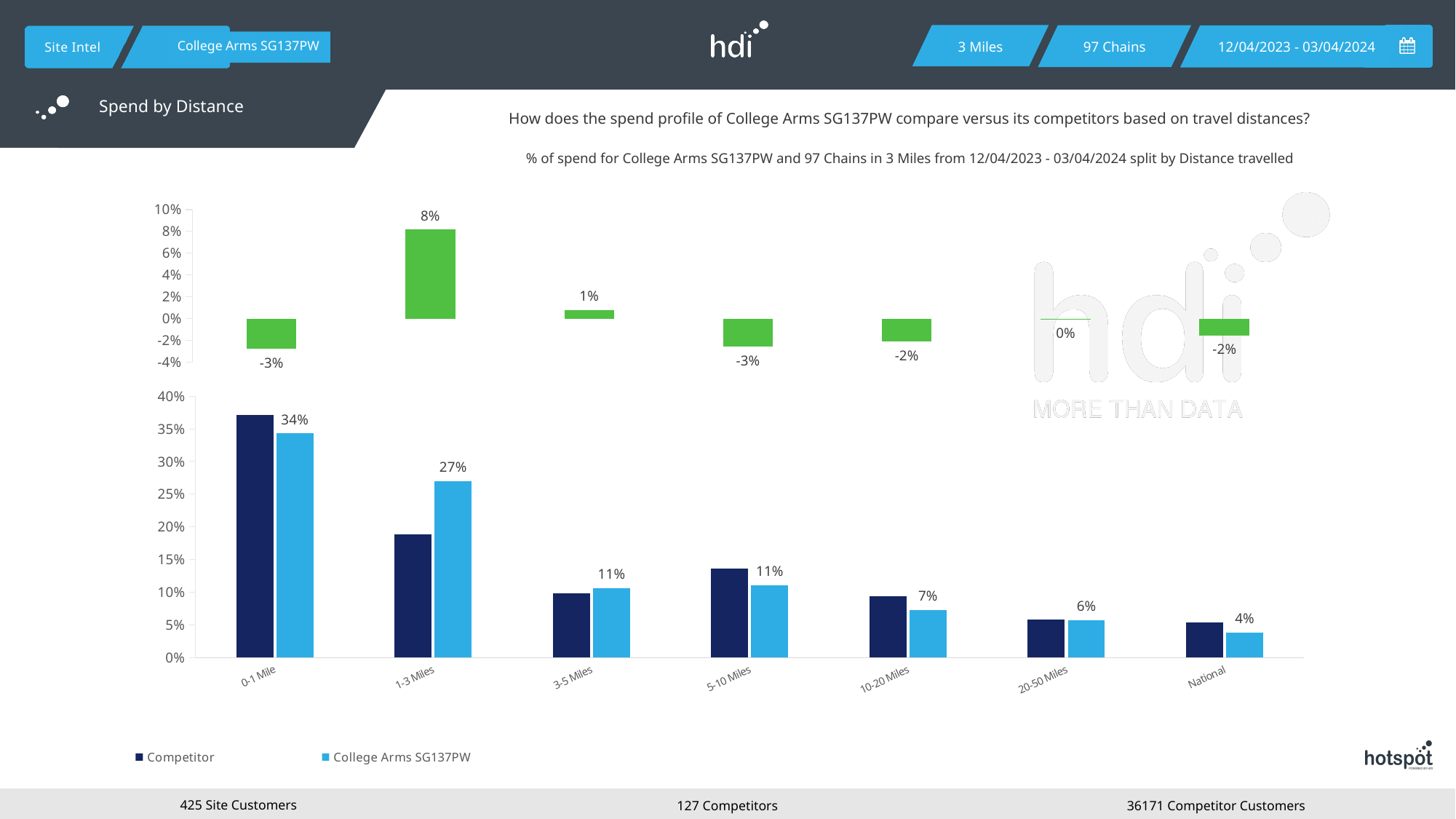
In the bottom chart, what is the value for College Arms SG137PW at 0-1 Mile? 34% In the top chart, what is the value shown for 1-3 Miles? 8% In the bottom chart, what is the value for College Arms SG137PW at National? 4% In the bottom chart, which is larger at 1-3 Miles: the Competitor bar or the College Arms SG137PW bar? College Arms SG137PW In the bottom chart, which distance band has the lowest College Arms SG137PW value? National In the bottom chart, what is the value for College Arms SG137PW at 1-3 Miles? 27% In the bottom chart, what is the difference between the College Arms SG137PW values at 0-1 Mile and 1-3 Miles? 7% In the top chart, which distance band has the highest value? 1-3 Miles In the bottom chart, is the Competitor value at 0-1 Mile greater or less than 35%? greater How many series does the legend of the bottom chart list? 2 In the bottom chart, which distance band has the highest College Arms SG137PW value? 0-1 Mile In the top chart, what is the value shown for 10-20 Miles? -2%